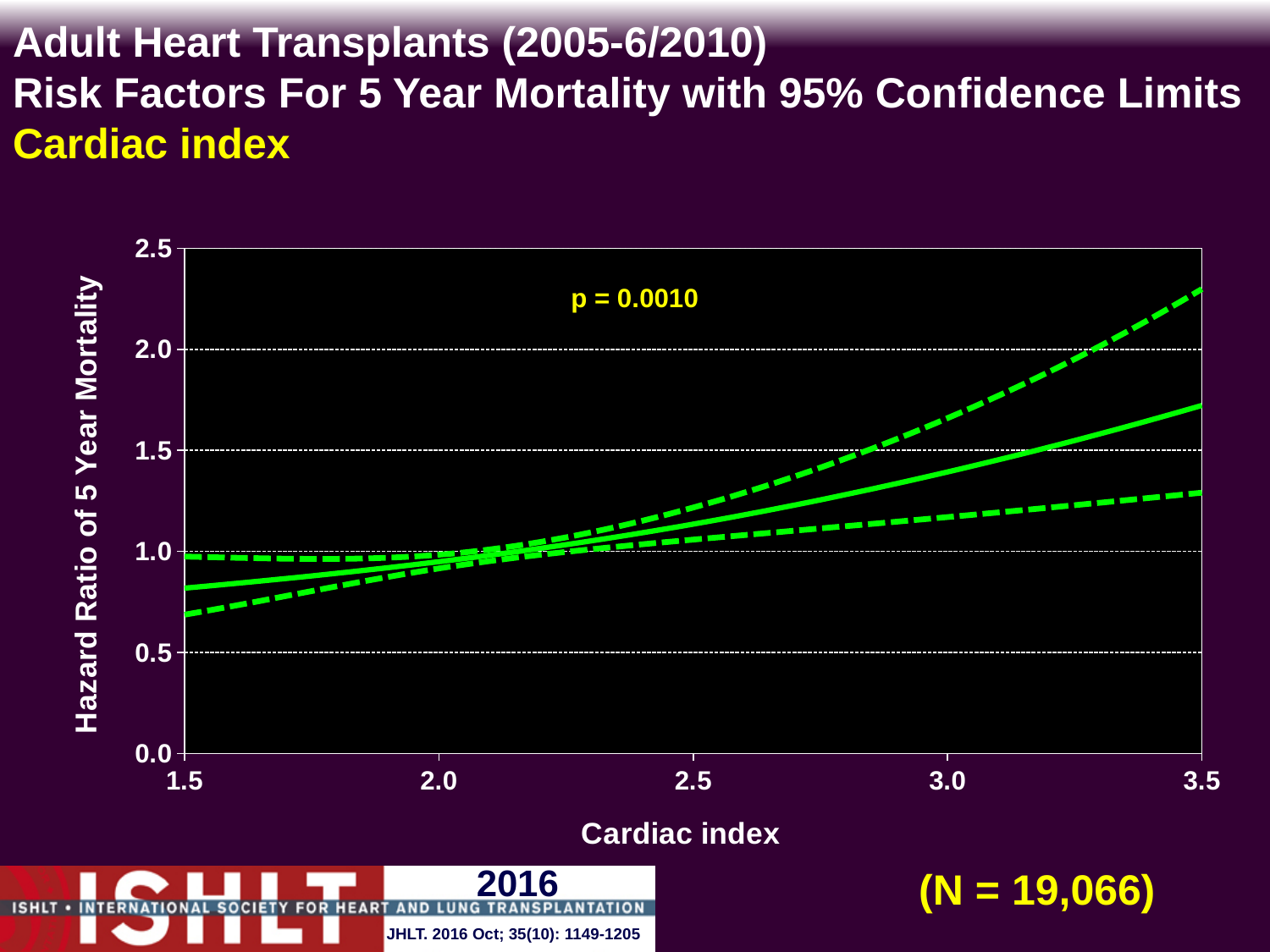
Is the hazard ratio (solid line) at a cardiac index of 1.5 greater or less than 1.0? less What is the sample size N shown on the slide? N = 19,066 Is the hazard ratio (solid line) at a cardiac index of 3.5 greater or less than 1.5? greater Does the hazard ratio of 5 year mortality rise or fall as cardiac index increases from 1.5 to 3.5? rise What p-value is shown on the chart? p = 0.0010 What kind of chart is shown on the slide? line chart How many lines are plotted on the chart? 3 Is the lower 95% confidence limit at a cardiac index of 3.5 greater or less than 1.5? less Which is larger at a cardiac index of 3.5: the upper confidence limit or the solid hazard ratio line? the upper confidence limit